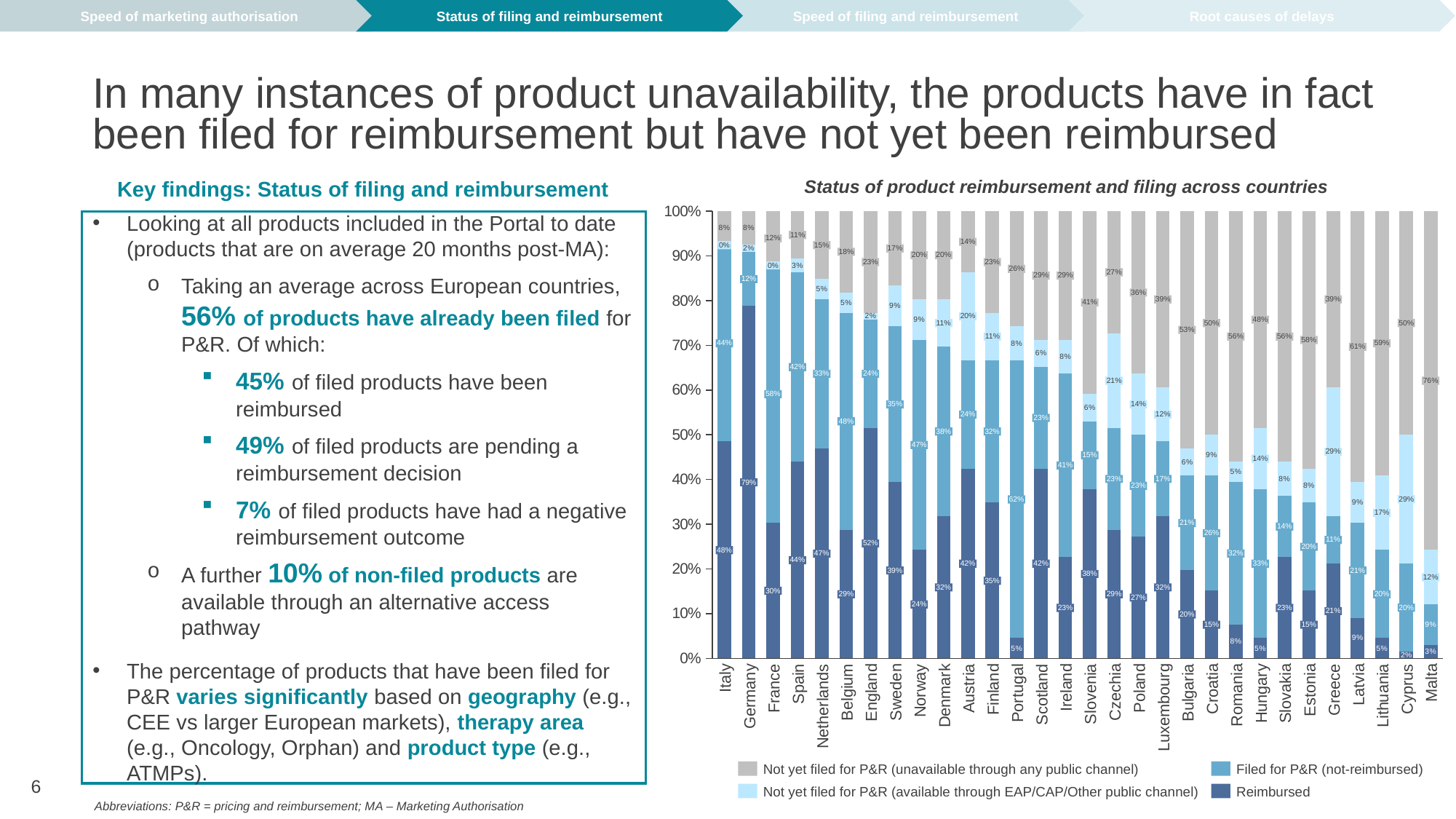
Which country has the largest share of products Not yet filed for P&R (unavailable through any public channel)? Malta Which has a larger Reimbursed share, Spain or Netherlands? Netherlands What percentage of products in Portugal are Filed for P&R (not-reimbursed)? 62% What percentage of products in Malta are Not yet filed for P&R (unavailable through any public channel)? 76% What percentage of products in Germany are shown as Reimbursed? 79% Which country has the highest Reimbursed share? Germany How many countries are shown on the x axis of the chart? 30 What is the Not yet filed for P&R (available through EAP/CAP/Other public channel) share for Greece? 29% What is the difference in percentage points between the Reimbursed share in Italy (48%) and in France (30%)? 18 percentage points How many series does the chart legend list? 4 Which legend entry is shown in grey? Not yet filed for P&R (unavailable through any public channel) What kind of chart is used to show the status of product reimbursement and filing across countries? Stacked bar chart